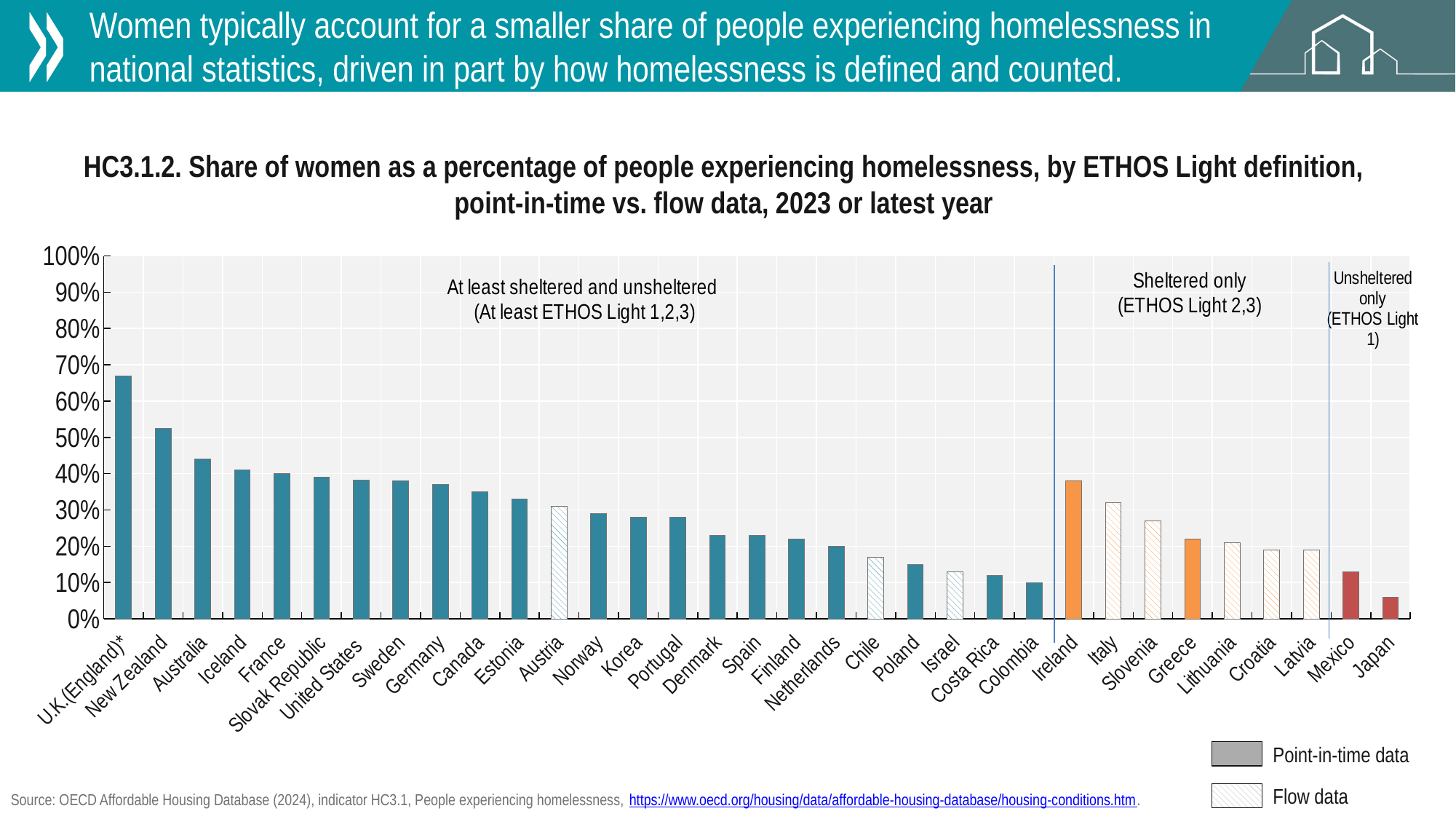
Is the value for New Zealand greater or less than 50%? greater How many countries are shown on the x axis of the chart? 33 What are the two legend entries of the chart? Point-in-time data and Flow data How many entries does the chart's legend list? 2 Is the value for U.K.(England)* greater or less than 60%? greater Which country has the lowest share of women among people experiencing homelessness in the chart? Japan What kind of chart is shown on the slide? bar chart Which has a higher share of women, Ireland or Italy? Ireland Is the value for Ireland greater or less than 30%? greater Which has a higher share of women, Mexico or Japan? Mexico Which country has the highest share of women among people experiencing homelessness in the chart? U.K.(England)*